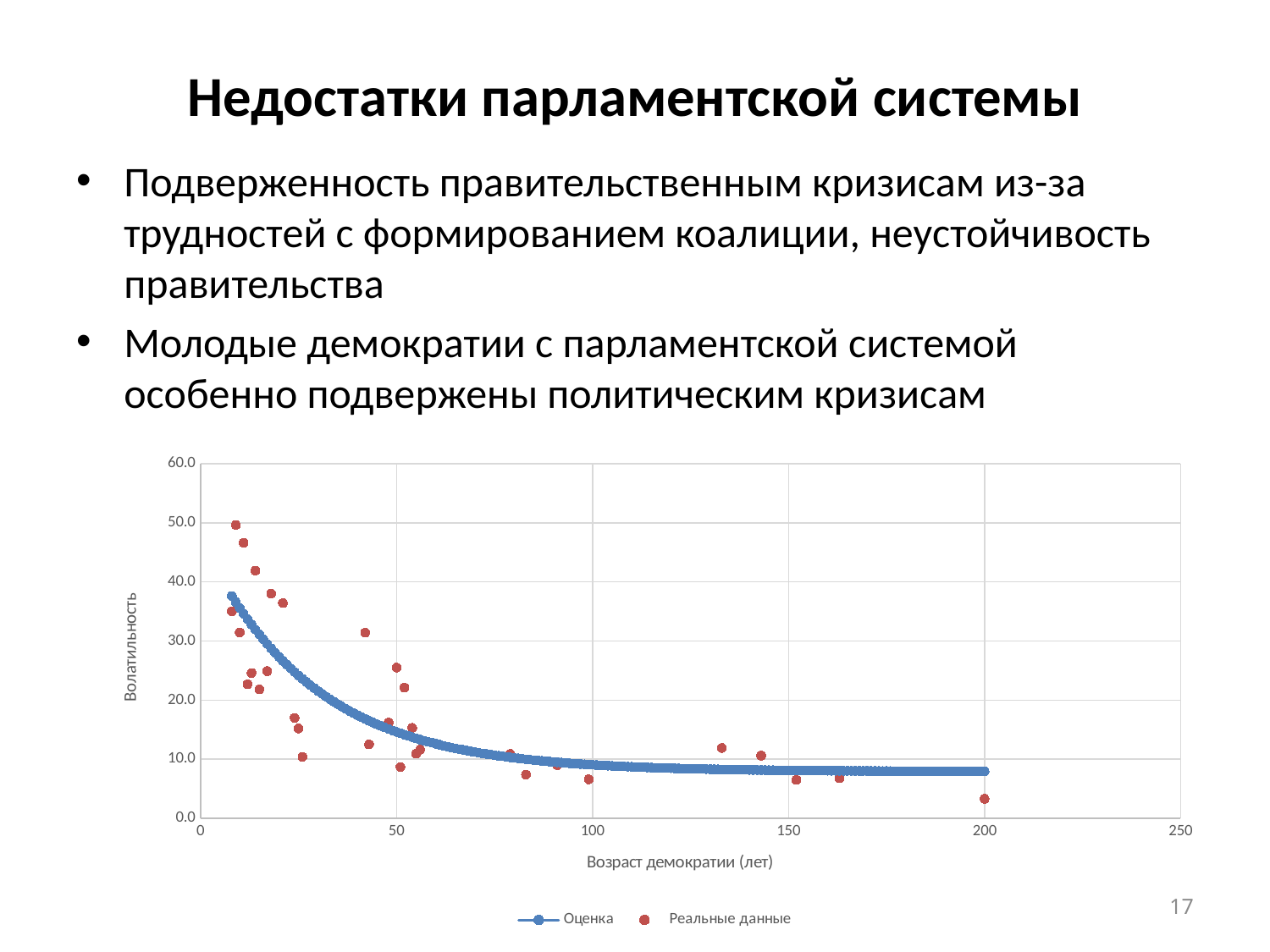
Is the value of the Оценка series at an age of 50 years greater or less than 20? less Which series has the higher value at an age of about 10 years, Оценка or Реальные данные (the topmost point)? Реальные данные Does the Оценка curve rise or fall as the age of democracy increases along the x axis? fall What kind of chart is shown on the slide? scatter chart Is the value of the Оценка series at an age of 200 years greater or less than 10? less Is the Реальные данные point at an age of 200 years greater or less than 10? less How many series does the chart legend list? 2 What are the names of the two series in the chart legend? Оценка and Реальные данные What is the title of the horizontal axis of the chart? Возраст демократии (лет)